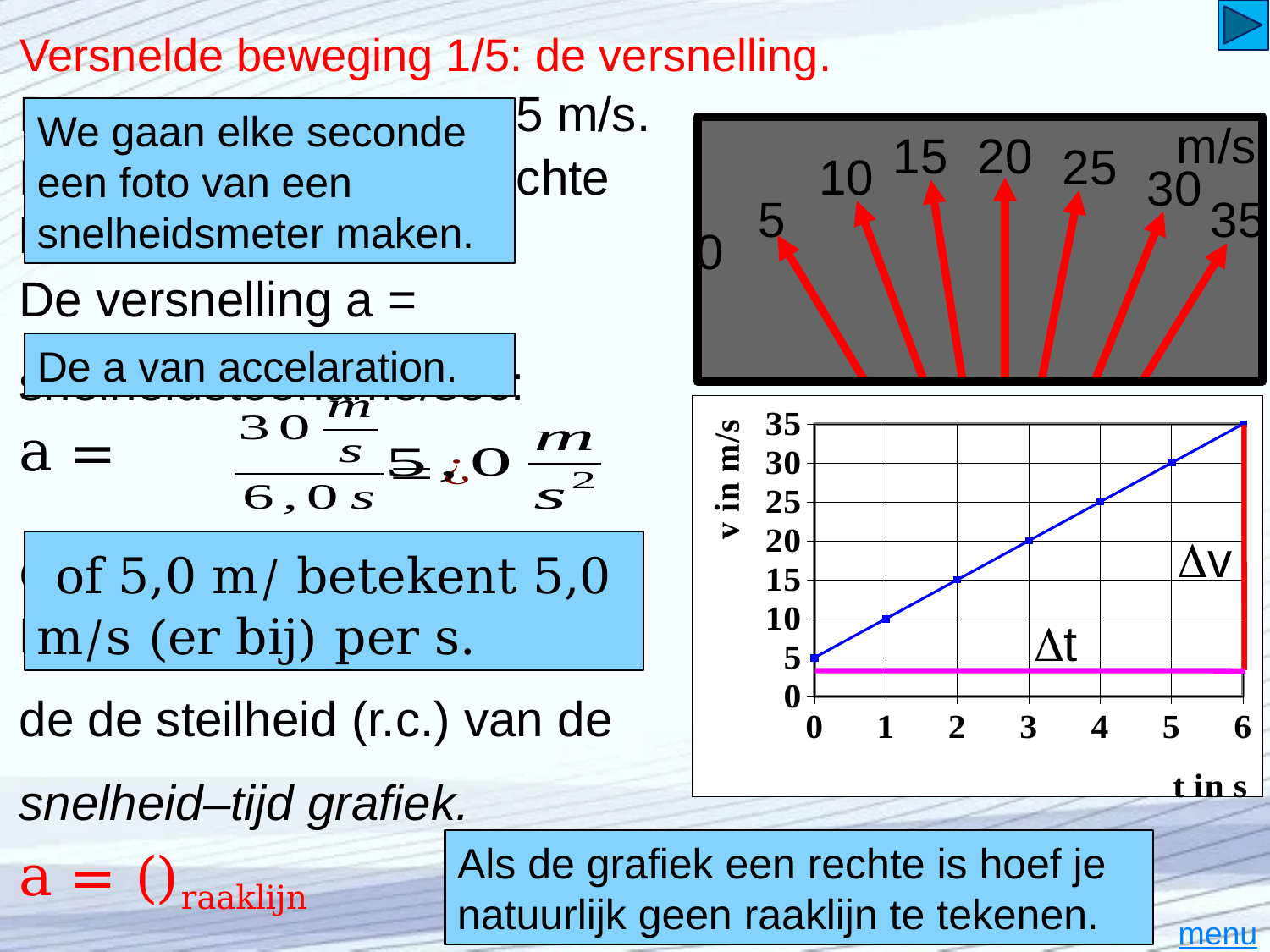
What is the label of the horizontal axis of the chart? t in s At which value of t is v lowest? 0 What is the difference between v at t = 6 s and v at t = 0 s? 30 What is the value of v at t = 3 s? 20 Which is larger, v at t = 2 s or v at t = 5 s? v at t = 5 s Does v rise or fall as t increases? rise What kind of chart is shown on the slide? line chart What is the label of the vertical axis of the chart? v in m/s What is the value of v at t = 6 s? 35 What is the value of v at t = 0 s? 5 At which value of t is v highest? 6 How many data points are plotted on the line? 7